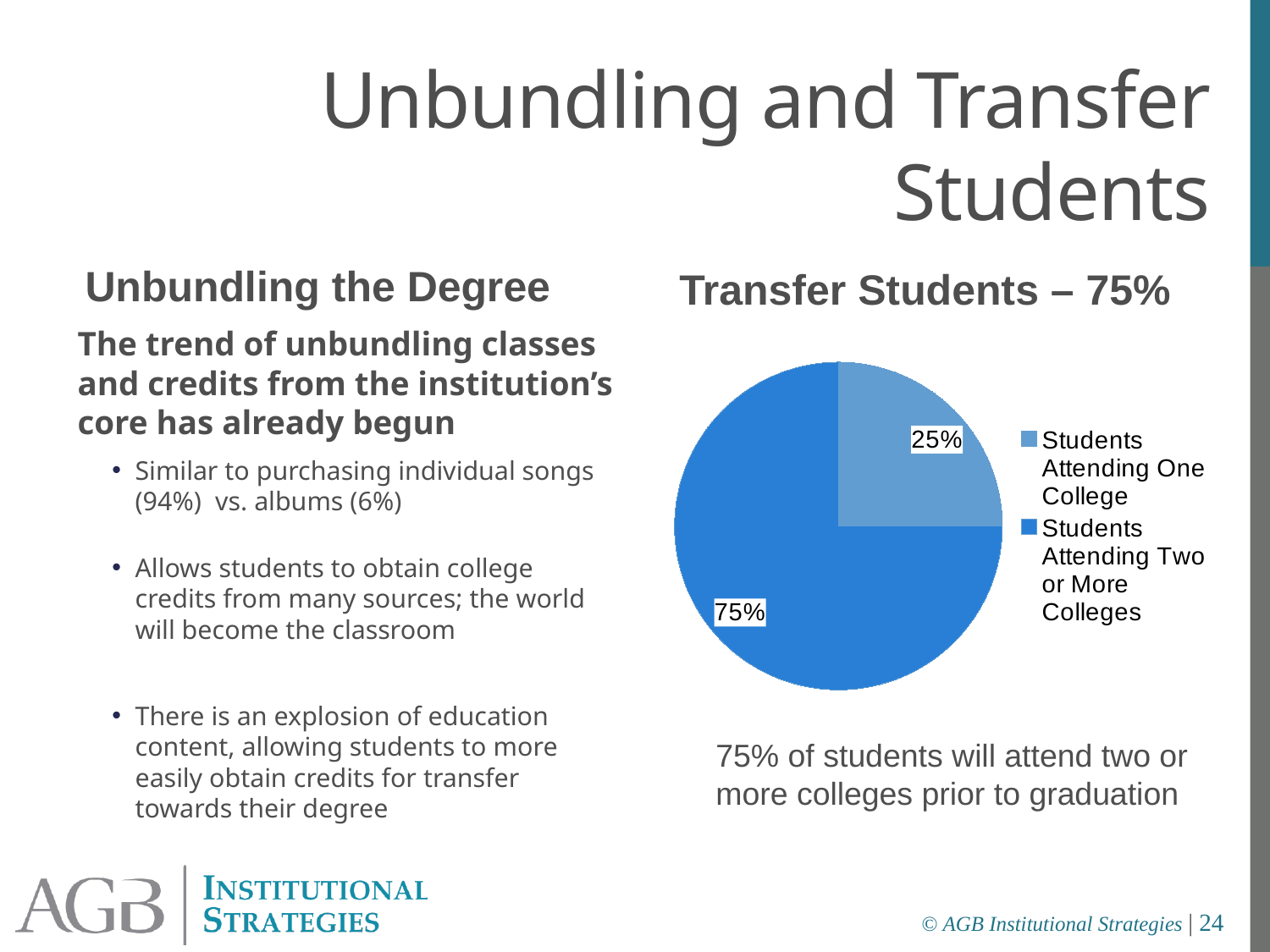
Which category has the smallest share of the pie? Students Attending One College What is the difference in percentage points between the two slices of the pie? 50 What kind of chart is shown on the slide? pie chart How many slices does the pie chart have? 2 Which category has the largest share of the pie? Students Attending Two or More Colleges What percentage of the pie is labelled for Students Attending Two or More Colleges? 75% How many entries does the legend list? 2 Which slice is drawn in the lighter blue colour? Students Attending One College What percentage of the pie is labelled for Students Attending One College? 25% Which slice is larger: Students Attending One College or Students Attending Two or More Colleges? Students Attending Two or More Colleges What is the title shown above the pie chart? Transfer Students – 75% What share of the pie does the Students Attending Two or More Colleges slice represent? 75%